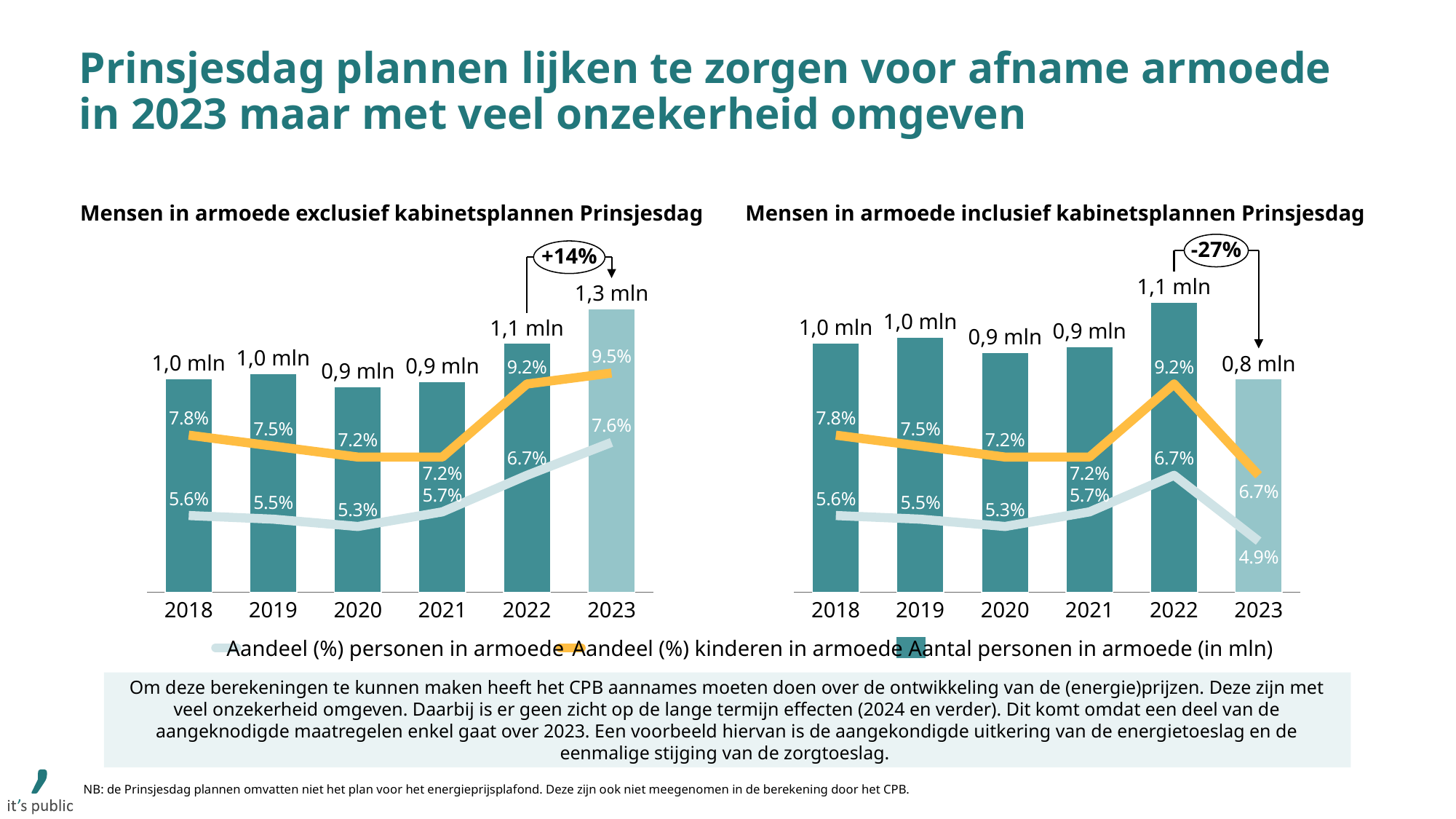
How many series does the legend list for the charts on the slide? 3 In the chart 'Mensen in armoede inclusief kabinetsplannen Prinsjesdag', does the share of children in poverty rise or fall from 2022 to 2023? Fall In the chart 'Mensen in armoede exclusief kabinetsplannen Prinsjesdag', what is the share of children in poverty (Aandeel (%) kinderen in armoede) in 2022? 9.2% In the chart 'Mensen in armoede exclusief kabinetsplannen Prinsjesdag', which year has the highest number of people in poverty? 2023 In the chart 'Mensen in armoede exclusief kabinetsplannen Prinsjesdag', what is the difference between the share of children in poverty and the share of persons in poverty in 2023? 1.9% In the chart 'Mensen in armoede inclusief kabinetsplannen Prinsjesdag', what is the number of people in poverty (Aantal personen in armoede) in 2023? 0,8 mln In the chart 'Mensen in armoede exclusief kabinetsplannen Prinsjesdag', what is the number of people in poverty (Aantal personen in armoede) in 2023? 1,3 mln In the chart 'Mensen in armoede inclusief kabinetsplannen Prinsjesdag', which year has the lowest share of persons in poverty (Aandeel (%) personen in armoede)? 2023 Is the number of people in poverty in 2023 larger in the chart 'Mensen in armoede exclusief kabinetsplannen Prinsjesdag' or in the chart 'Mensen in armoede inclusief kabinetsplannen Prinsjesdag'? Exclusief kabinetsplannen Prinsjesdag What percentage change is annotated between 2022 and 2023 in the chart 'Mensen in armoede inclusief kabinetsplannen Prinsjesdag'? -27% How many years are shown on the x axis of the chart 'Mensen in armoede inclusief kabinetsplannen Prinsjesdag'? 6 In the chart 'Mensen in armoede inclusief kabinetsplannen Prinsjesdag', what is the share of persons in poverty (Aandeel (%) personen in armoede) in 2023? 4.9%